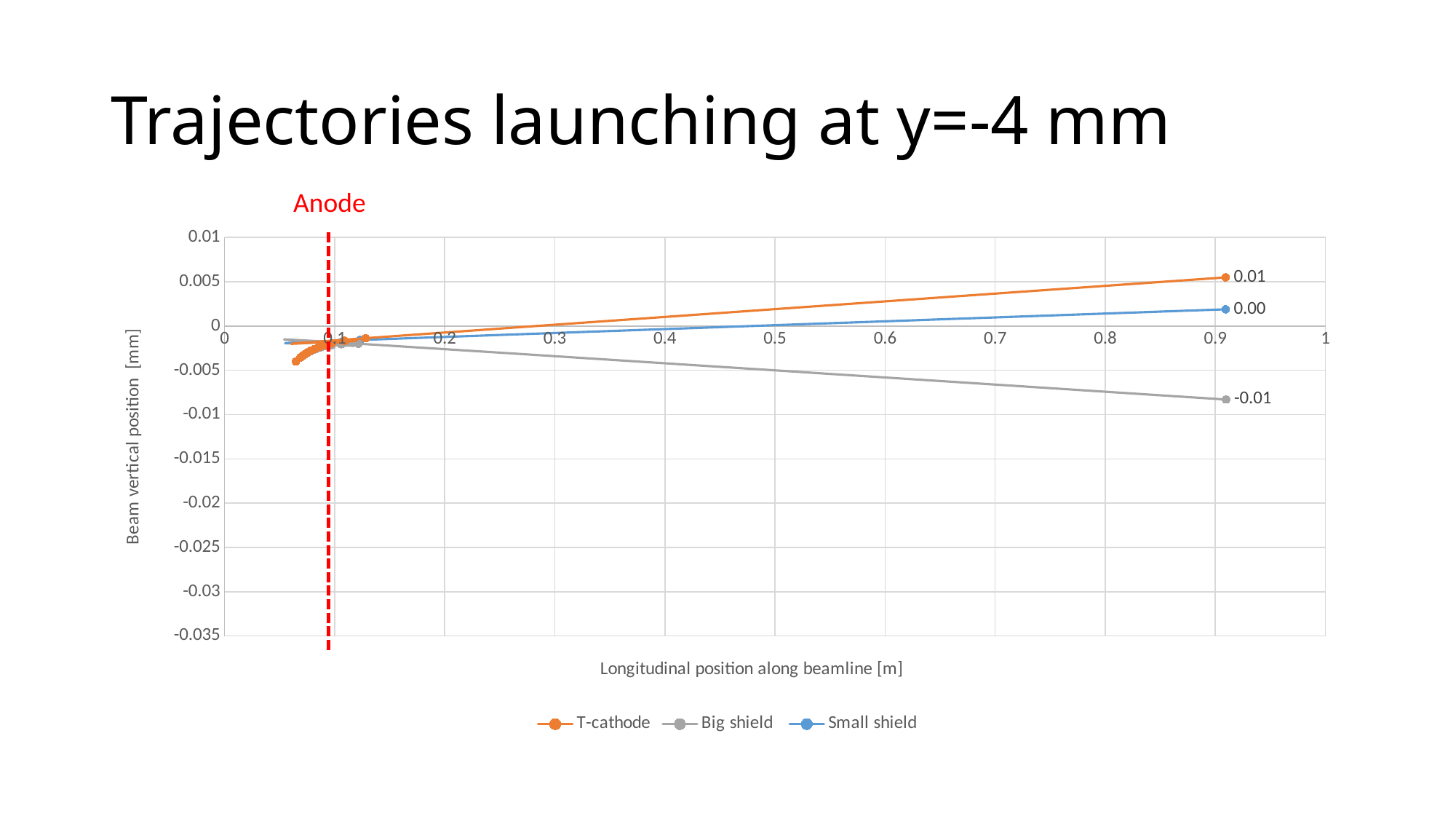
At the right end of the chart, which is higher: the T-cathode line or the Small shield line? T-cathode Does the Big shield line rise or fall as the longitudinal position increases beyond the anode? fall What kind of chart is shown on the slide? line chart What data label is printed at the end of the Small shield line? 0.00 Which series ends at the highest vertical position at the right end of the chart? T-cathode Which series ends at the lowest vertical position at the right end of the chart? Big shield What data label is printed at the end of the T-cathode line? 0.01 What is the title of the slide containing the chart? Trajectories launching at y=-4 mm Is the final value of the Big shield line greater or less than -0.005? less How many series does the legend list? 3 What are the three series named in the legend? T-cathode, Big shield, Small shield What data label is printed at the end of the Big shield line? -0.01